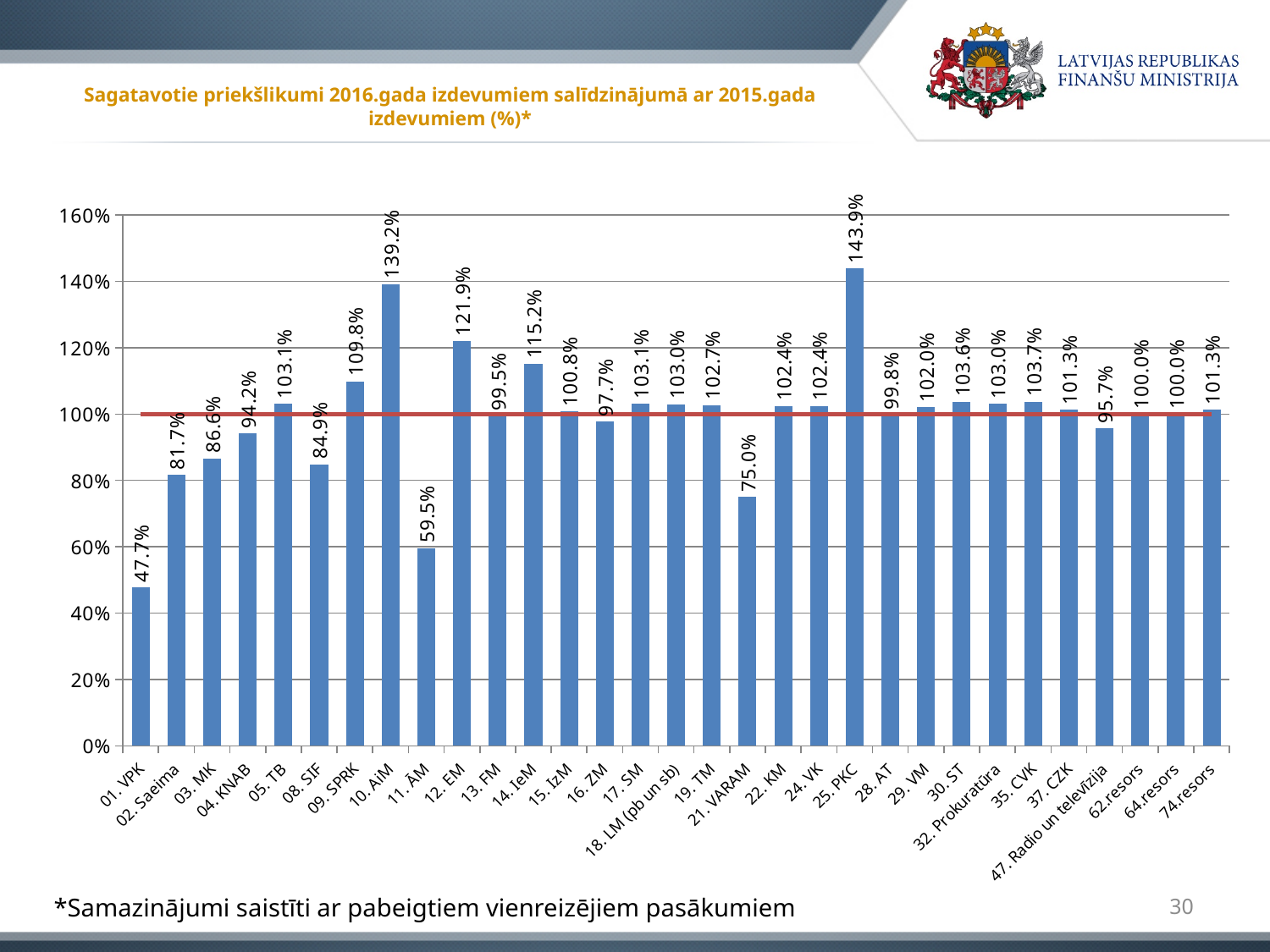
What is the value for 01. VPK? 47.7% At what level is the horizontal red line drawn across the chart? 100% What is the value for 21. VARAM? 75.0% Which category has the lowest value? 01. VPK Which category has the highest value? 25. PKC Which is larger, the value for 12. EM or the value for 14. IeM? 12. EM What is the value for 25. PKC? 143.9% How many categories are shown on the x axis? 31 Is the value for 09. SPRK greater or less than 100%? greater What kind of chart is shown on the slide? Bar chart What is the difference between the values for 10. AiM and 11. ĀM? 79.7 percentage points What is the value for 47. Radio un televīzija? 95.7%